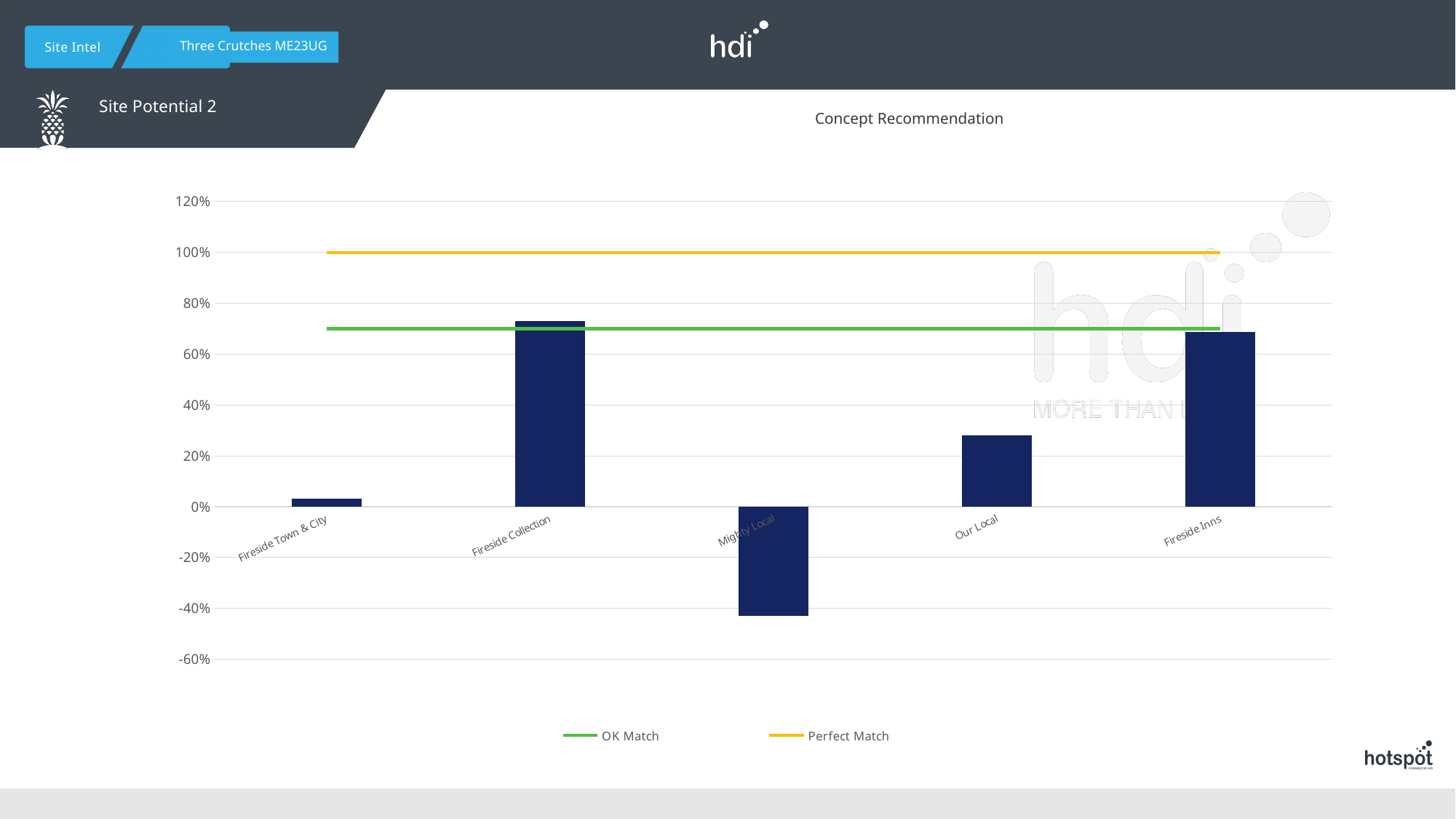
Which concept has the lowest bar? Mighty Local Is the value for Our Local greater or less than 20%? greater Is the value for Fireside Town & City greater or less than 20%? less Is the value for Mighty Local greater or less than -20%? less How many entries does the legend list? 2 Which is larger, the value for Fireside Collection or the value for Our Local? Fireside Collection Which concept has the highest bar? Fireside Collection At what level on the y axis is the Perfect Match line drawn? 100% What kind of chart is shown on the slide? bar chart What colour is the OK Match line in the legend? green How many concept categories are plotted on the x axis? 5